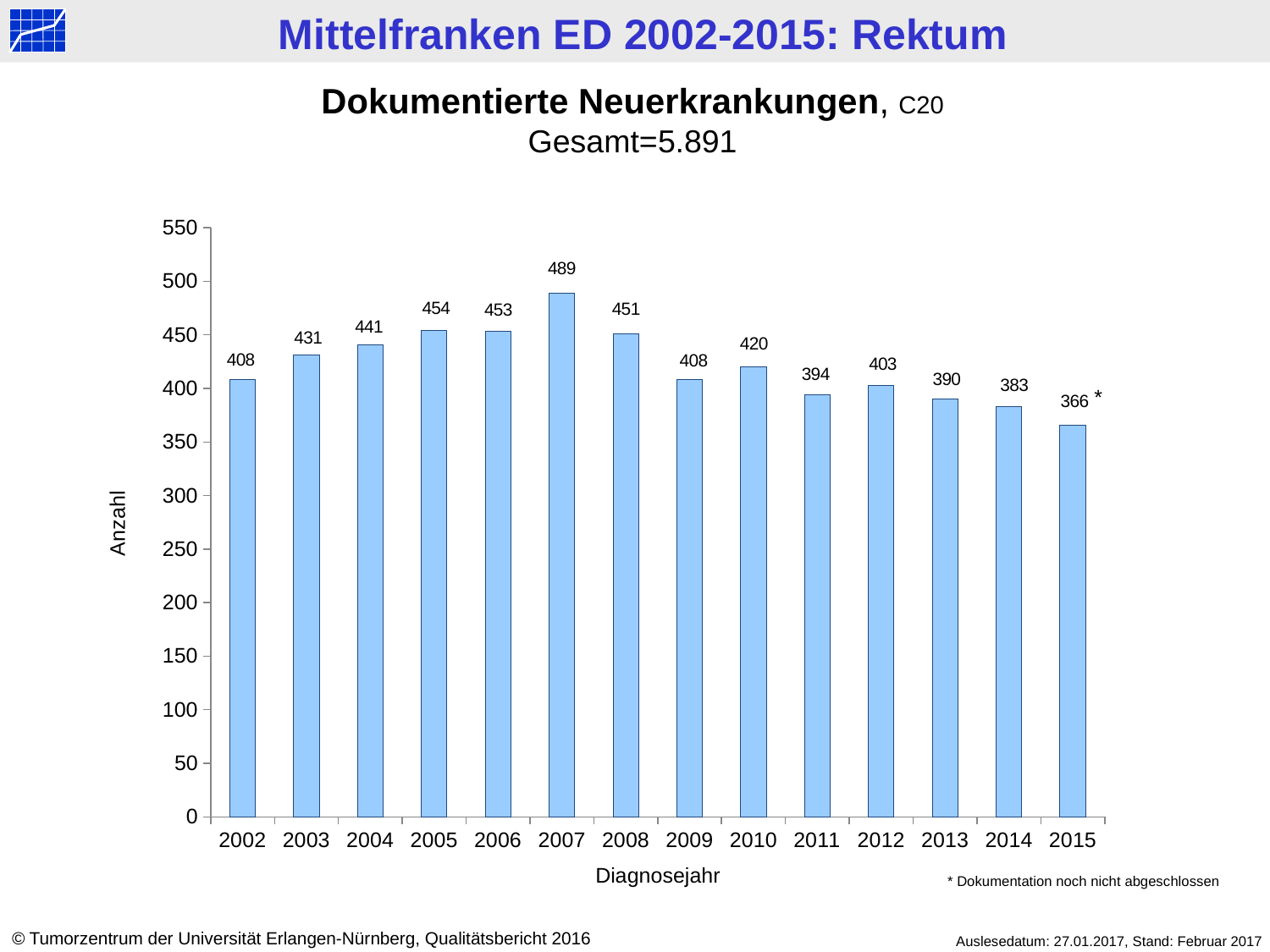
Which year has the lowest value? 2015 Which year has the highest value? 2007 Do the values rise or fall from 2008 to 2009? fall What is the value for 2015? 366 What kind of chart is this? bar chart What is the value for 2011? 394 What is the difference between the values for 2005 and 2006? 1 How many years are shown on the x axis? 14 Which is larger, the value for 2010 or the value for 2012? 2010 What is the value for 2007? 489 What is the label of the y axis? Anzahl What is the difference between the values for 2007 and 2015? 123